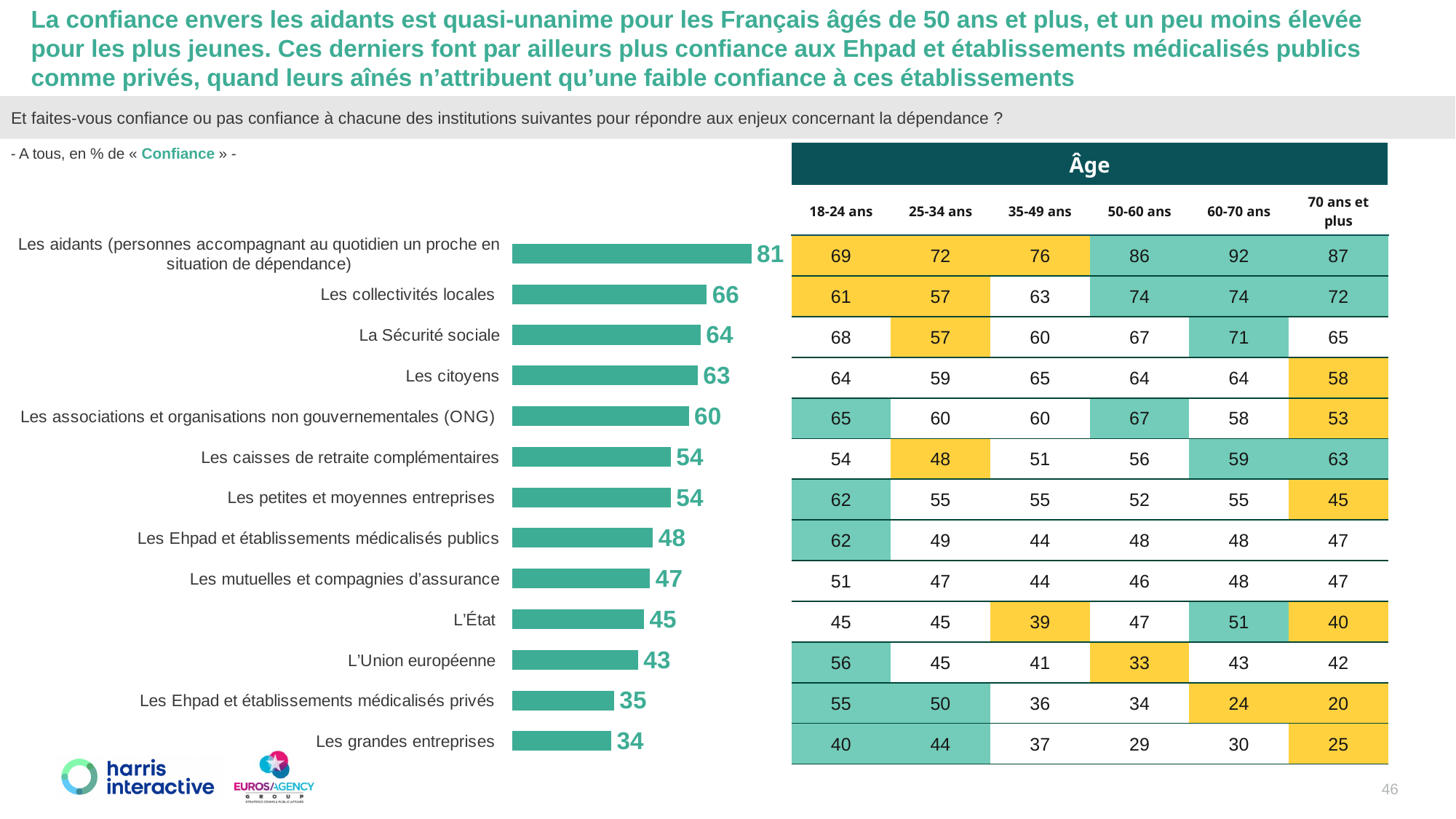
Which has a larger value in the bar chart, "Les citoyens" or "Les mutuelles et compagnies d'assurance"? Les citoyens What is the difference between the values for "Les aidants" and "Les grandes entreprises" in the bar chart? 47 What kind of chart is shown on the slide? Bar chart What is the value shown for "Les Ehpad et établissements médicalisés privés" in the bar chart? 35 Which category has the highest value in the bar chart? Les aidants (personnes accompagnant au quotidien un proche en situation de dépendance) What is the value shown for "La Sécurité sociale" in the bar chart? 64 Which category has the lowest value in the bar chart? Les grandes entreprises Which two categories in the bar chart share the same value of 54? Les caisses de retraite complémentaires and Les petites et moyennes entreprises What is the value shown for "L'Union européenne" in the bar chart? 43 What is the value shown for "Les aidants (personnes accompagnant au quotidien un proche en situation de dépendance)" in the bar chart? 81 How many categories are shown in the bar chart? 13 What is the difference between the values for "Les collectivités locales" and "L'État" in the bar chart? 21